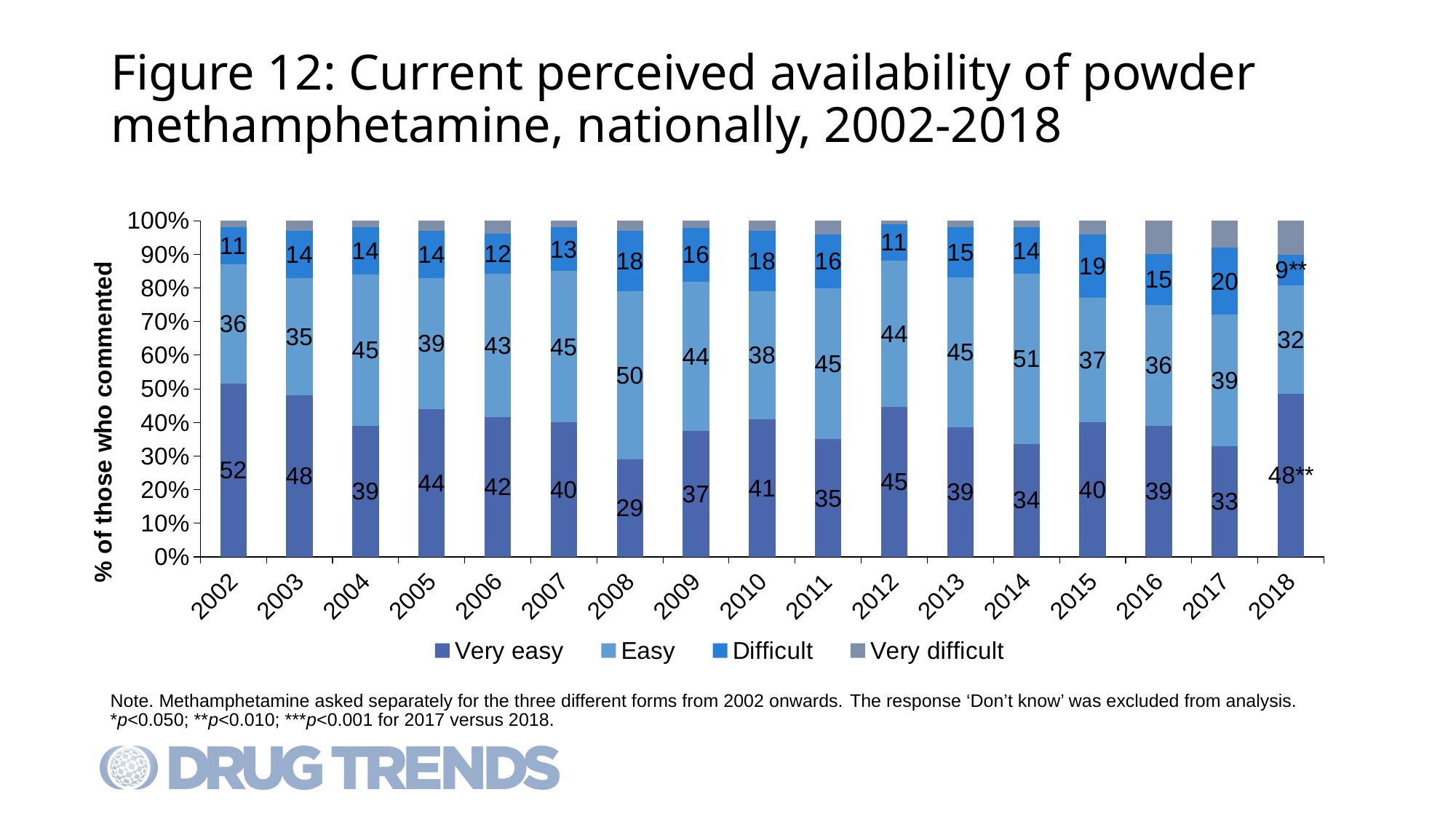
In which year is the 'Difficult' value the highest? 2017 What percentage of respondents rated powder methamphetamine as 'Very easy' to obtain in 2002? 52 How many series does the legend list? 4 What is the 'Difficult' value shown for 2018? 9** How many years are shown on the x axis? 17 In which year is the 'Very easy' value the lowest? 2008 Which year has a larger 'Easy' value, 2008 or 2010? 2008 In which year is the 'Very easy' value the highest? 2002 What is the difference between the 'Very easy' values for 2018 and 2017? 15 What kind of chart is shown on the slide? Stacked bar chart What is the 'Easy' value for 2014? 51 Does the 'Very easy' value rise or fall from 2002 to 2008? Fall